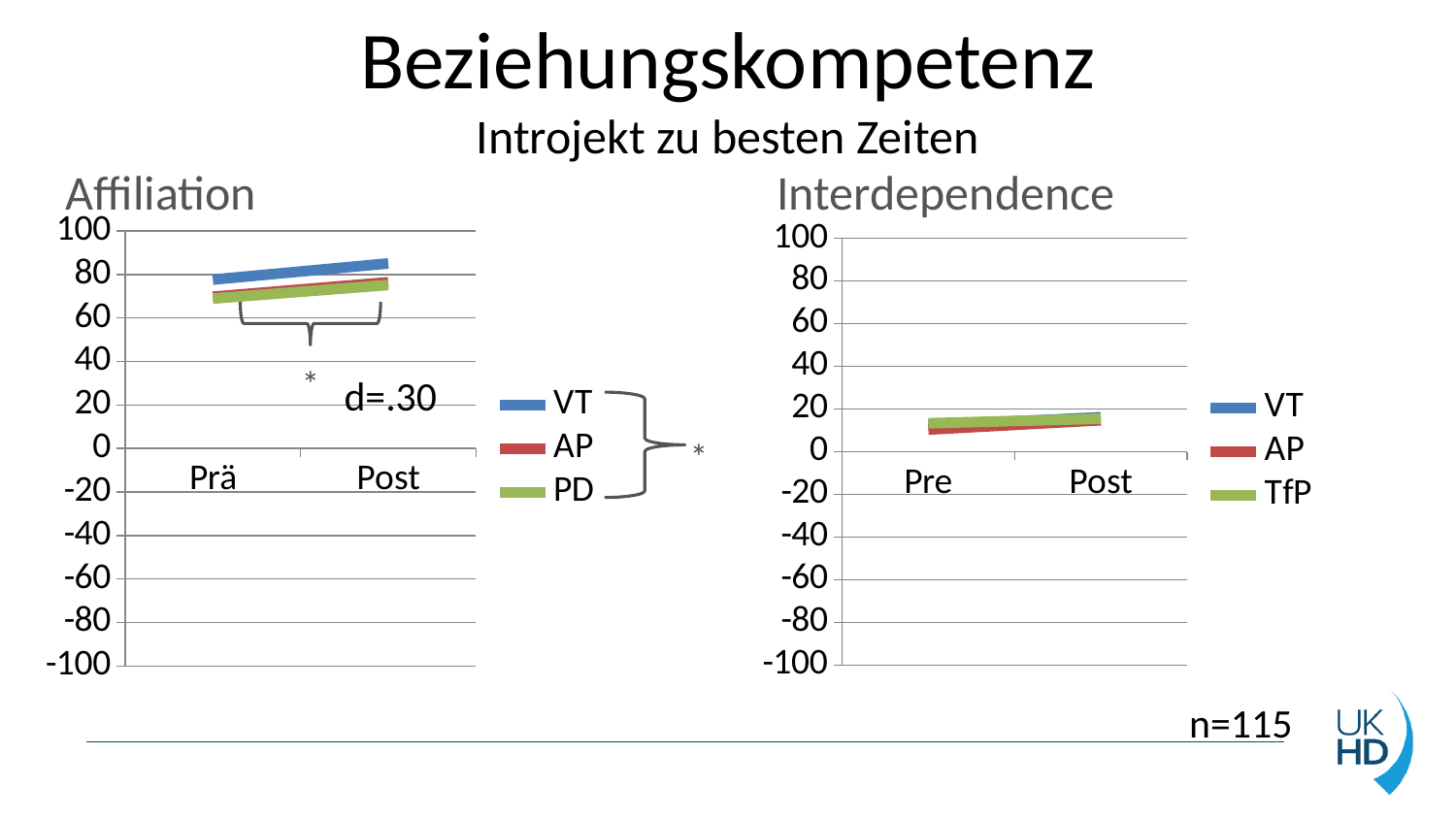
How many series does the legend of the Interdependence chart list? 3 In the Interdependence chart, does the TfP line rise or fall from Pre to Post? rise What are the x-axis category labels of the Affiliation chart? Prä, Post In the Affiliation chart, which series has the highest values? VT In the Interdependence chart, is the value for VT at Post greater or less than 20? less In the Affiliation chart, does the VT line rise or fall from Prä to Post? rise What kind of chart is the Affiliation chart? line chart In the Affiliation chart, which is larger at Post: VT or PD? VT How many series does the legend of the Affiliation chart list? 3 What are the legend entries of the Interdependence chart? VT, AP, TfP In the Affiliation chart, is the value for VT at Post greater or less than 80? greater How many categories are on the x axis of the Affiliation chart? 2